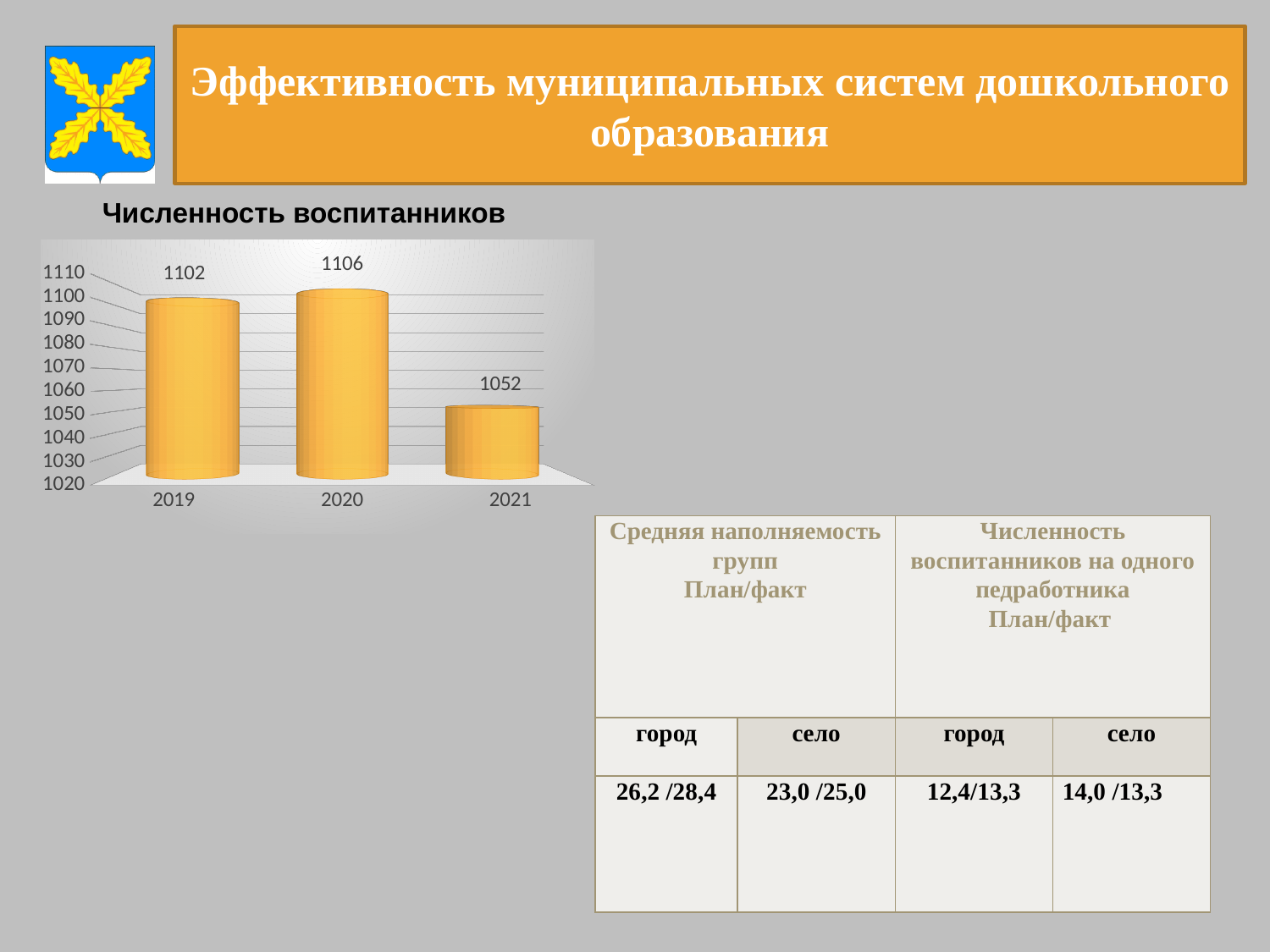
What is the value for 2021 in the chart? 1052 Which year has the lowest value in the chart? 2021 Which is larger, the value for 2019 or the value for 2021? 2019 What kind of chart is shown on the slide? bar chart What is the title of the chart? Численность воспитанников What is the difference between the values for 2019 and 2021? 50 What is the difference between the values for 2020 and 2021? 54 Is the value for 2021 greater or less than 1060? less How many years are shown in the chart? 3 What is the value for 2020 in the chart? 1106 What is the value for 2019 in the chart? 1102 Which year has the highest value in the chart? 2020